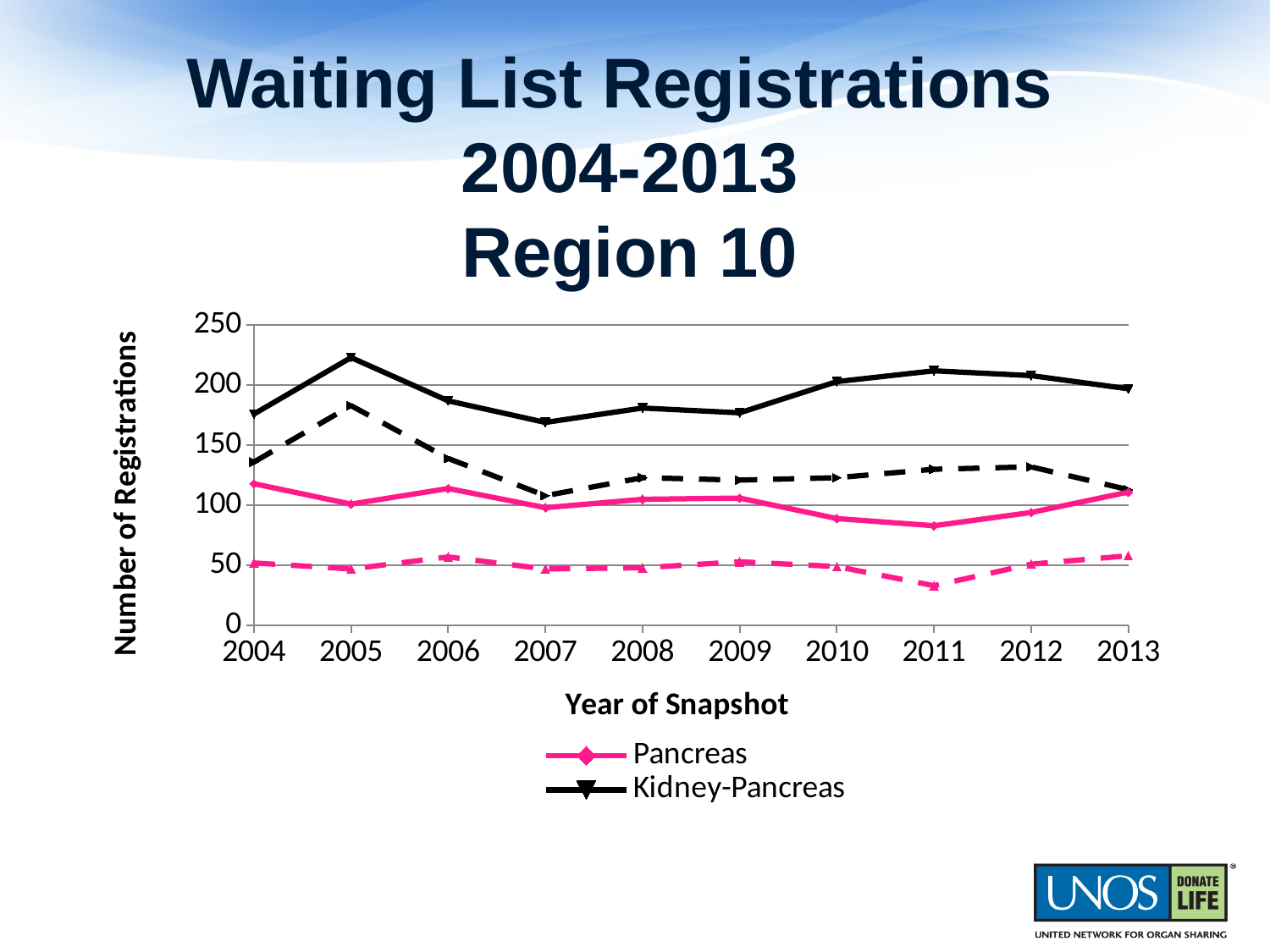
Is the Kidney-Pancreas value for 2007 greater or less than 200? less Is the Kidney-Pancreas value for 2005 greater or less than 200? greater How many series does the legend list? 2 Is the Pancreas value for 2011 greater or less than 100? less How many years are shown on the x axis? 10 In which year is the Pancreas line at its lowest? 2011 What is the title of the y axis? Number of Registrations In which year is the Kidney-Pancreas line at its highest? 2005 Does the Kidney-Pancreas line rise or fall from 2005 to 2007? Fall In 2008, which series has the larger value, Pancreas or Kidney-Pancreas? Kidney-Pancreas What kind of chart is shown on the slide? Line chart